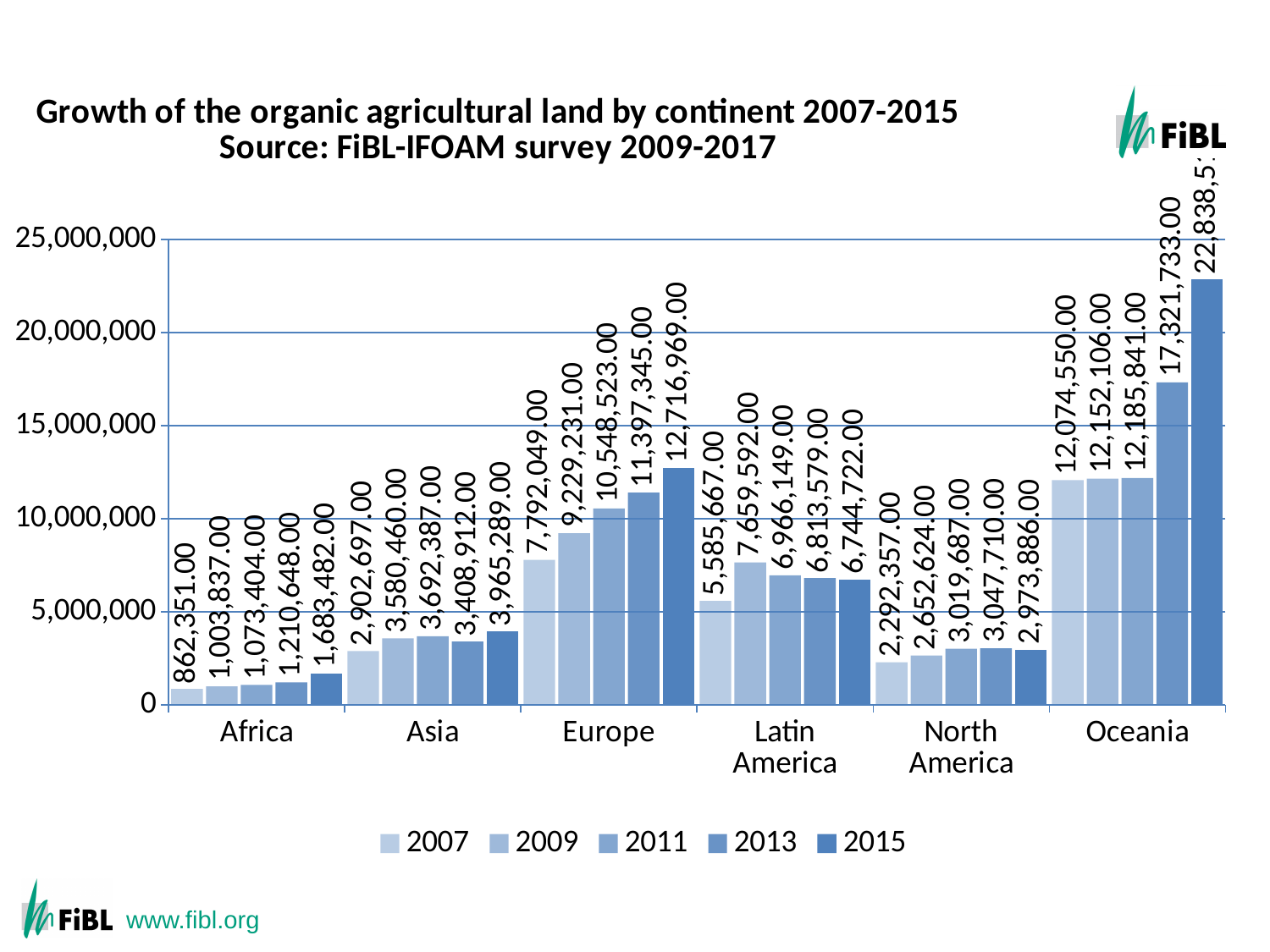
What is the value for Asia in 2011? 3,692,387.00 What is the value for Africa in 2007? 862,351.00 What is the value for Europe in 2015? 12,716,969.00 What is the value for Oceania in 2013? 17,321,733.00 What kind of chart is shown on the slide? bar chart What is the difference between Europe's 2015 value and its 2007 value? 4,924,920.00 How many continents are shown on the x axis? 6 Which continent has the lowest value in 2007? Africa Which continent has the highest value in 2015? Oceania Which is larger, the 2015 value for Asia or the 2015 value for North America? Asia Is the value for Oceania in 2015 greater or less than 20,000,000? greater How many series does the legend list? 5